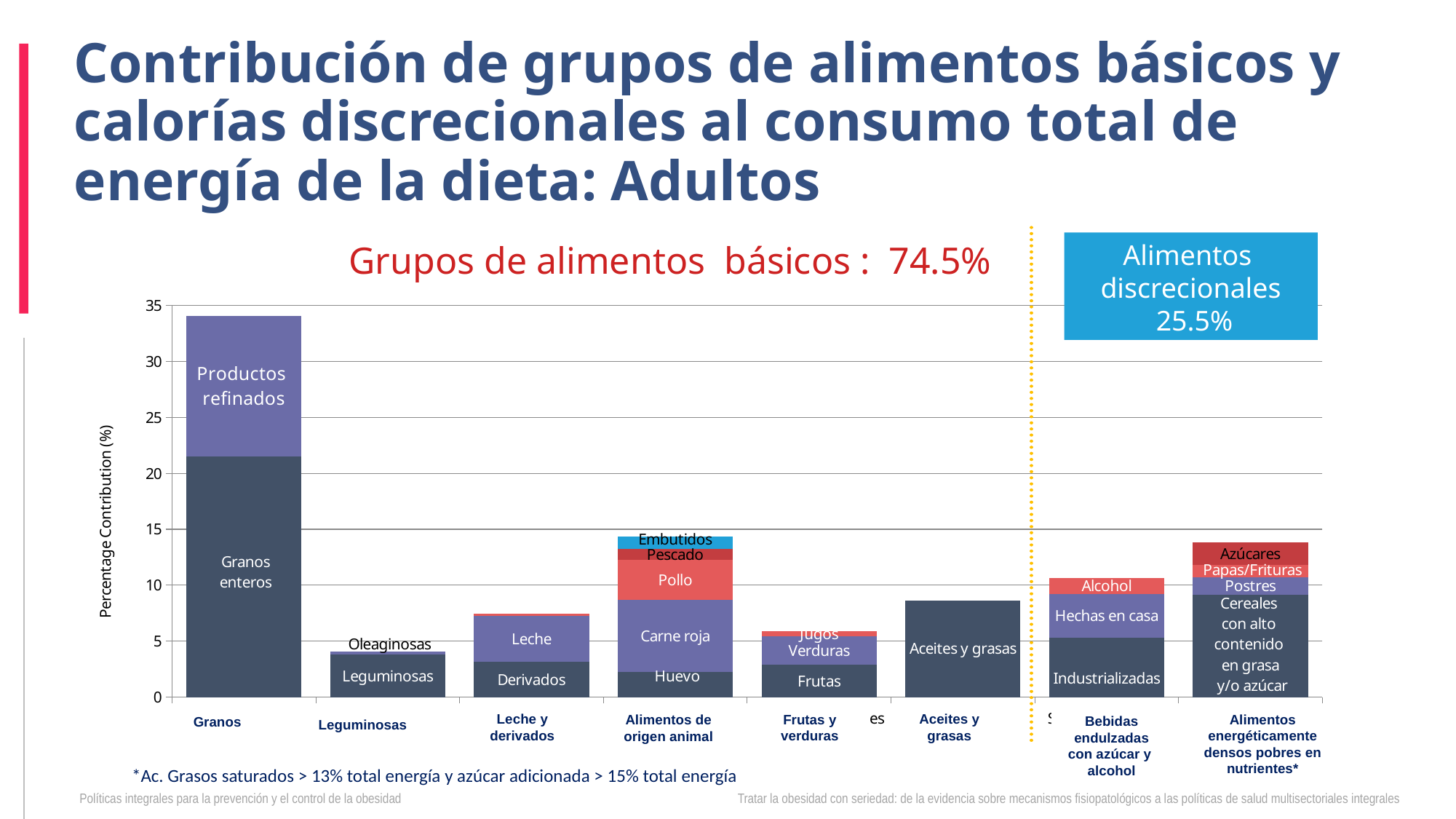
Which food group has the highest total percentage contribution? Granos Is the total value for Granos greater or less than 30? greater What is the label of the y axis of the chart? Percentage Contribution (%) How many food group categories are shown along the x axis of the chart? 8 Which has a larger total contribution, Alimentos de origen animal or Aceites y grasas? Alimentos de origen animal Which has a larger total contribution, Leche y derivados or Frutas y verduras? Leche y derivados Which food group has the lowest total percentage contribution? Leguminosas What kind of chart is shown on the slide? Stacked bar chart According to the slide, what percentage of total energy intake comes from Grupos de alimentos básicos? 74.5% Is the total value for Leguminosas greater or less than 5? less Is the total value for Aceites y grasas greater or less than 10? less